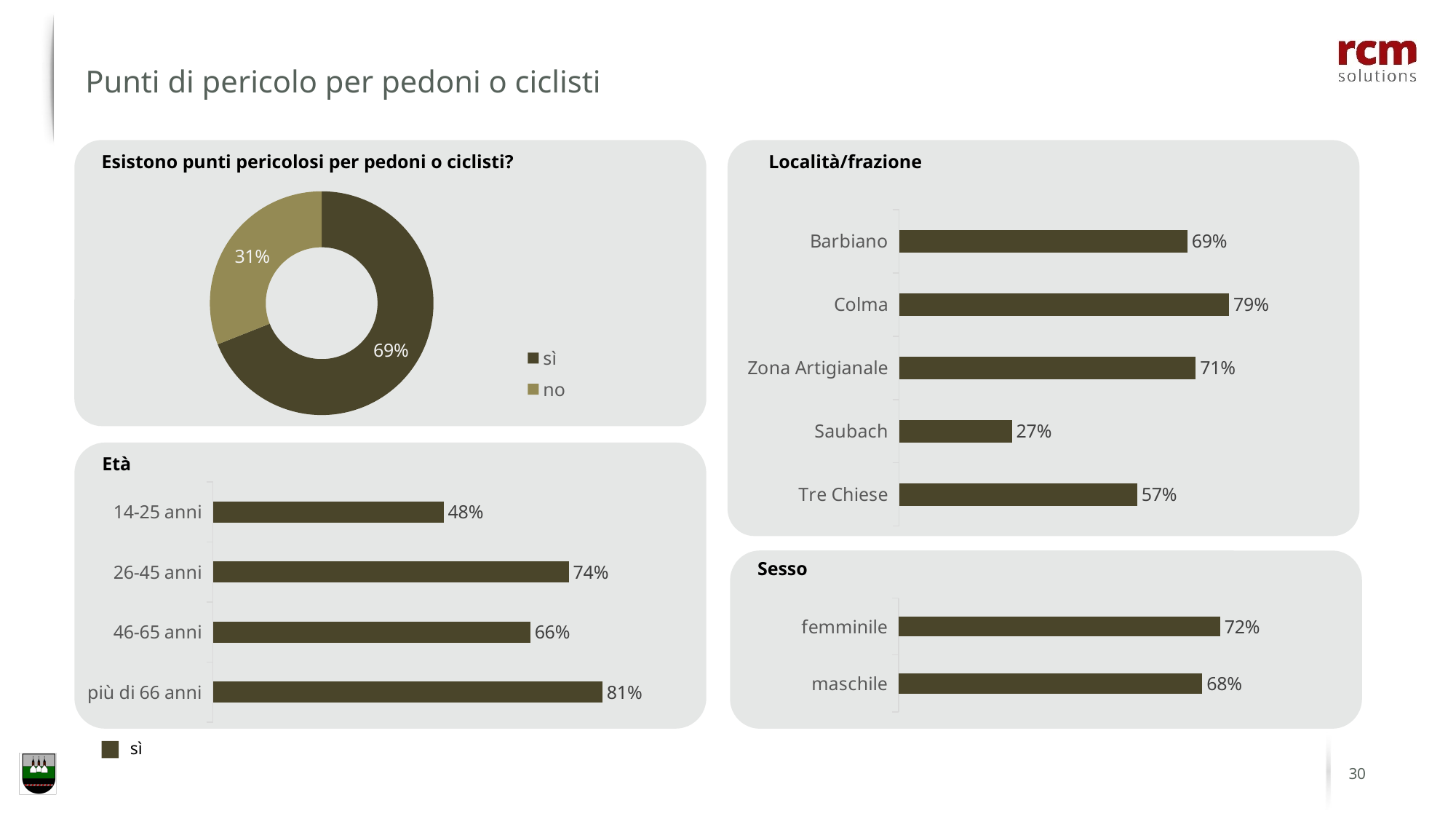
How many categories are shown in the 'Località/frazione' chart? 5 In the 'Sesso' chart, what is the difference between femminile and maschile? 4 percentage points In the 'Sesso' chart, which is larger, femminile or maschile? femminile In the 'Località/frazione' chart, which locality has the highest value? Colma What kind of chart is the 'Esistono punti pericolosi per pedoni o ciclisti?' chart? Doughnut chart In the 'Esistono punti pericolosi per pedoni o ciclisti?' chart, what share of the pie does 'no' take? 31% In the 'Esistono punti pericolosi per pedoni o ciclisti?' chart, what percentage answered 'sì'? 69% In the 'Località/frazione' chart, what is the difference between Colma and Saubach? 52 percentage points In the 'Età' chart, what is the value for '26-45 anni'? 74% In the 'Età' chart, which age group has the highest value? più di 66 anni In the 'Località/frazione' chart, which locality has the lowest value? Saubach In the 'Località/frazione' chart, what is the value for Tre Chiese? 57%